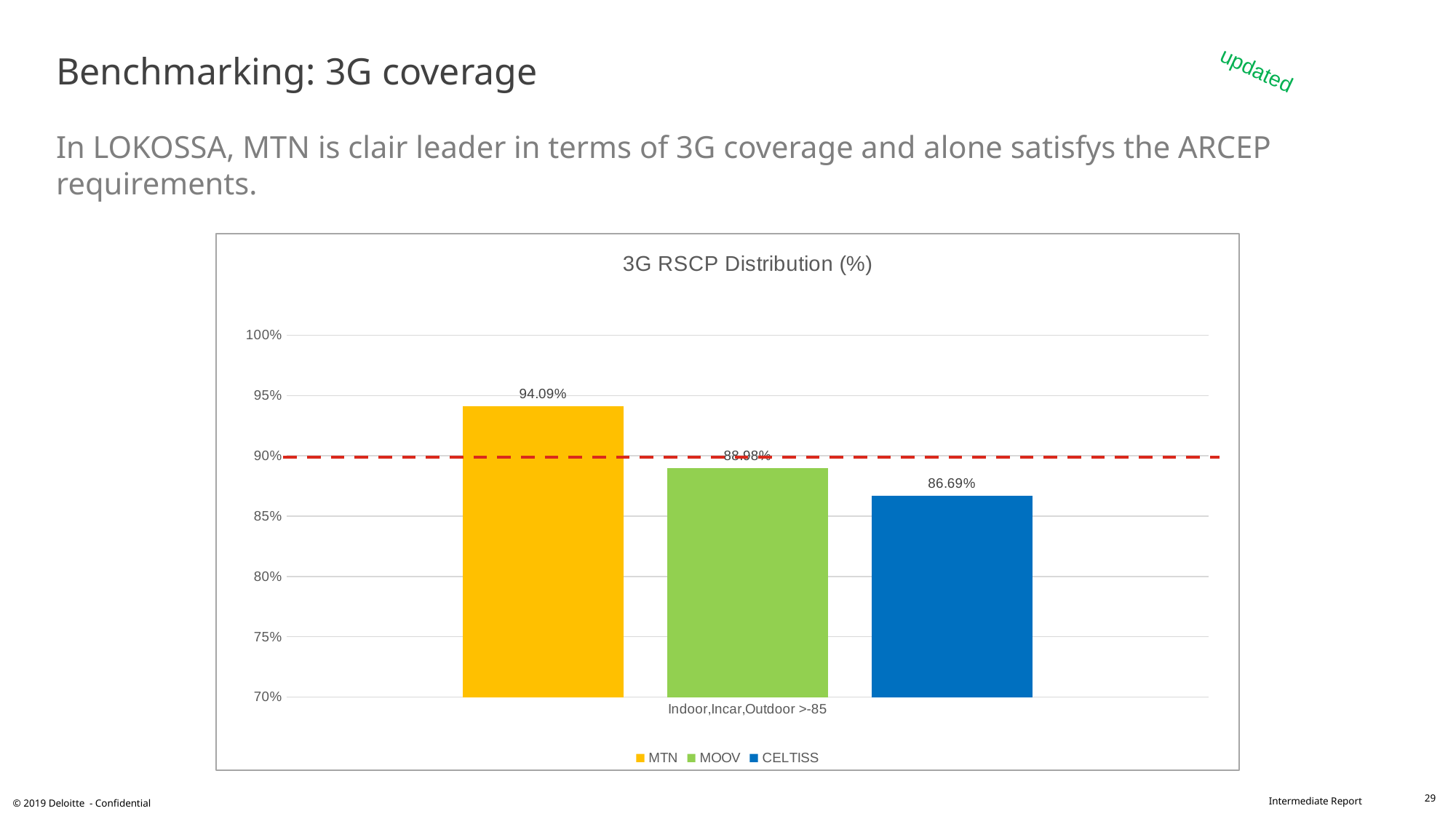
Which operator has the lowest value in the 3G RSCP Distribution chart? CELTISS What is the title of the chart? 3G RSCP Distribution (%) What is the value for MTN in the 3G RSCP Distribution chart? 94.09% What colour is the MTN bar? yellow Which is larger, the value for MTN or the value for MOOV? MTN What kind of chart is shown on the slide? bar chart What is the value for CELTISS in the 3G RSCP Distribution chart? 86.69% Which operator has the highest value in the 3G RSCP Distribution chart? MTN What is the difference between the MTN value and the CELTISS value? 7.40% Is the value for MOOV greater or less than 85%? greater Is the value for CELTISS greater or less than 90%? less How many series does the legend list? 3